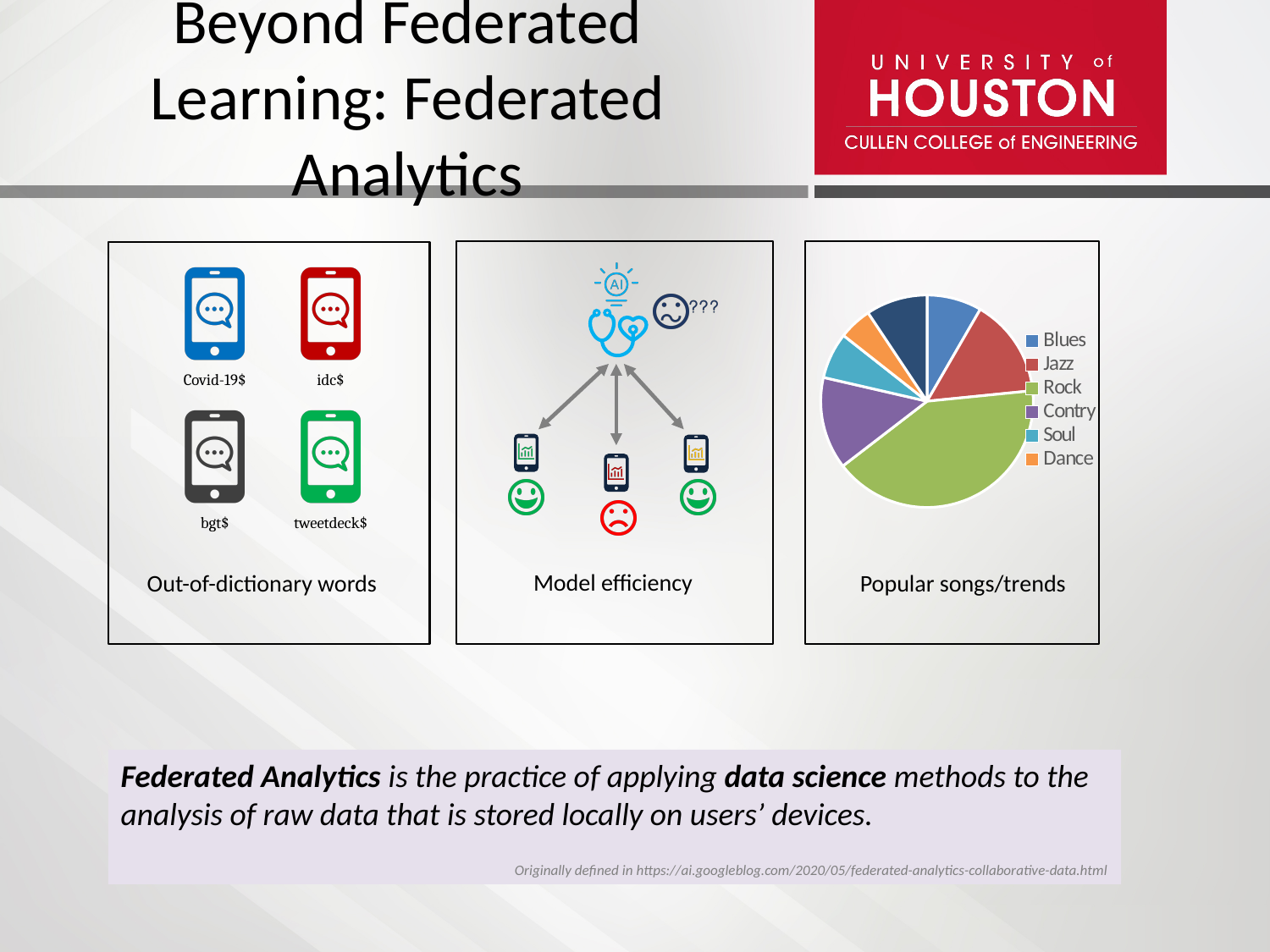
In the "Popular songs/trends" pie chart, which slice is larger, Contry or Soul? Contry In the "Popular songs/trends" pie chart, which slice is larger, Rock or Jazz? Rock In the "Popular songs/trends" pie chart, which slice is larger, Jazz or Blues? Jazz Which category has the largest slice in the "Popular songs/trends" pie chart? Rock What kind of chart is shown in the "Popular songs/trends" panel? pie chart Which category has the smallest slice in the "Popular songs/trends" pie chart? Dance What colour is the Rock slice in the "Popular songs/trends" pie chart? green What is the caption under the pie chart in the rightmost panel? Popular songs/trends